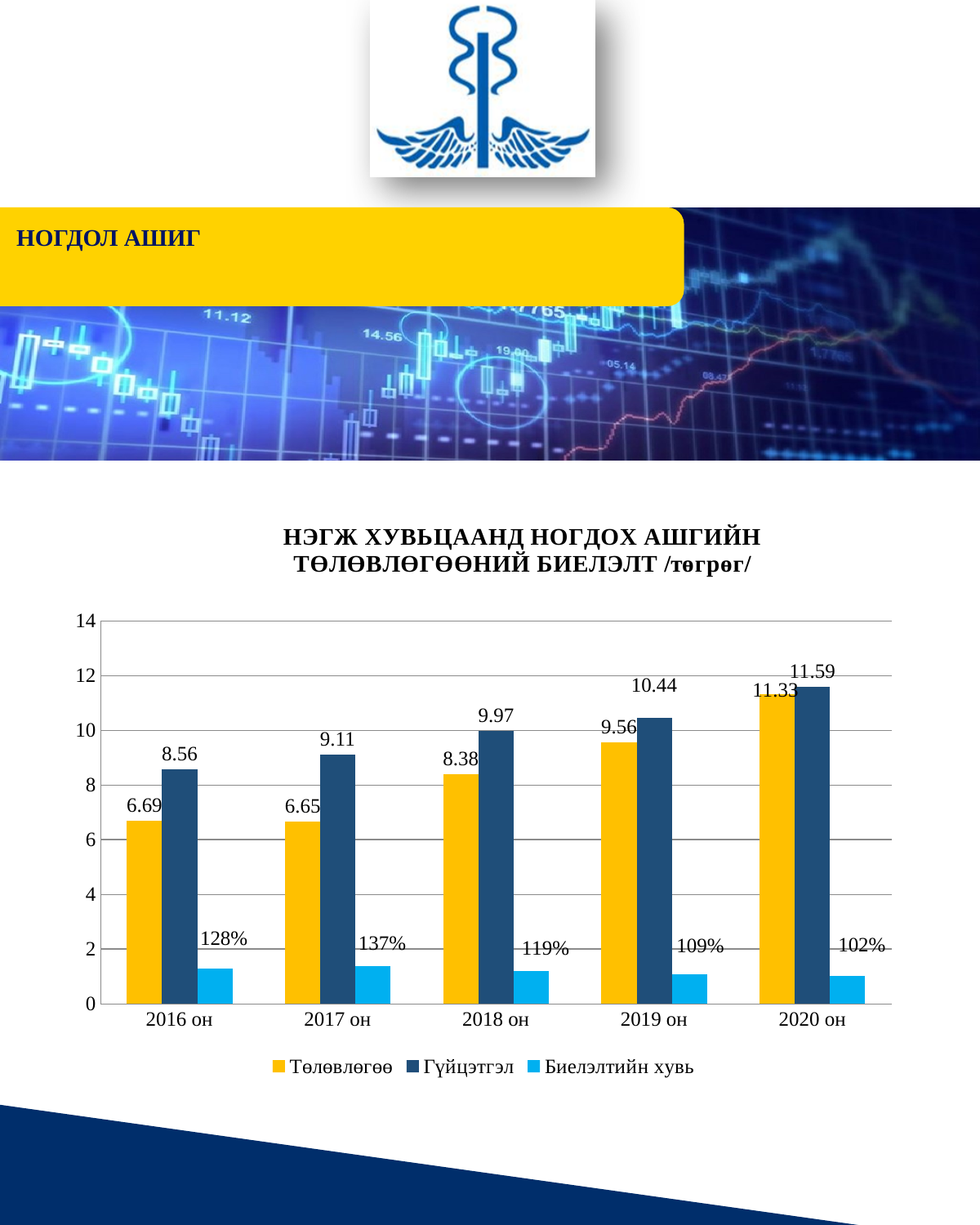
What is the Биелэлтийн хувь value for 2016 он? 128% What is the value of Төлөвлөгөө for 2017 он? 6.65 In which year is the Биелэлтийн хувь value lowest? 2020 он How many series does the legend list? 3 In which year is the Гүйцэтгэл value highest? 2020 он What type of chart is shown on the slide? bar chart Do the Гүйцэтгэл values rise or fall from 2016 он to 2020 он? rise What unit is given in parentheses in the chart title? төгрөг Which is larger for 2016 он, Төлөвлөгөө or Гүйцэтгэл? Гүйцэтгэл What is the difference between Гүйцэтгэл and Төлөвлөгөө for 2019 он? 0.88 What is the value of Гүйцэтгэл for 2018 он? 9.97 How many years are shown on the x axis? 5